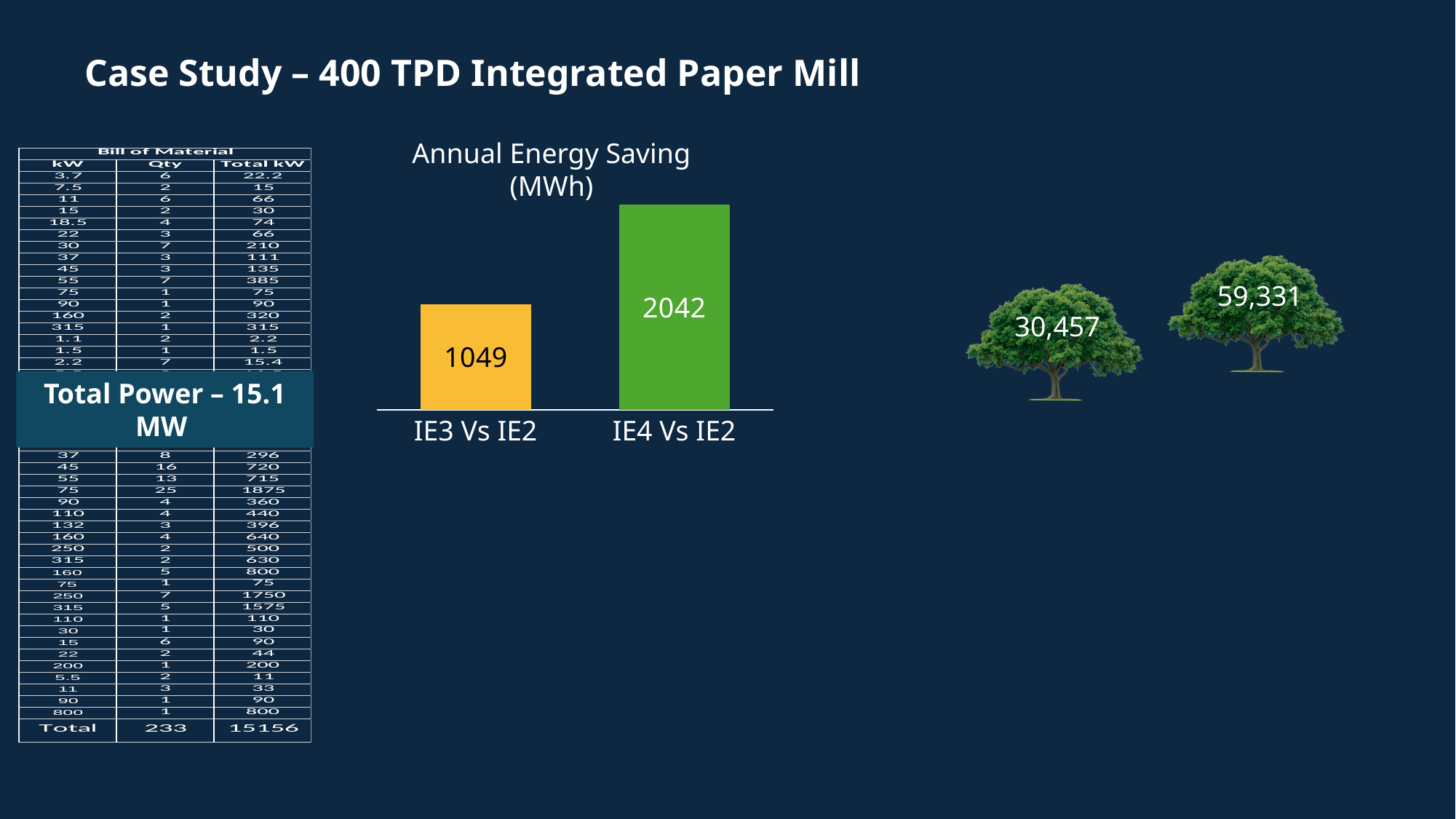
What is the difference between the IE4 Vs IE2 and IE3 Vs IE2 values in the Annual Energy Saving (MWh) chart? 993 Which category has the highest value in the Annual Energy Saving (MWh) chart? IE4 Vs IE2 What is the annual energy saving value for IE3 Vs IE2 in the Annual Energy Saving (MWh) chart? 1049 What is the title of the chart on the slide? Annual Energy Saving (MWh) In the Annual Energy Saving (MWh) chart, which is larger: IE3 Vs IE2 or IE4 Vs IE2? IE4 Vs IE2 What colour is the IE4 Vs IE2 bar in the Annual Energy Saving (MWh) chart? green How many categories are shown in the Annual Energy Saving (MWh) chart? 2 Which category has the lowest value in the Annual Energy Saving (MWh) chart? IE3 Vs IE2 What is the annual energy saving value for IE4 Vs IE2 in the Annual Energy Saving (MWh) chart? 2042 What kind of chart is the Annual Energy Saving (MWh) chart? bar chart Do the values rise or fall from IE3 Vs IE2 to IE4 Vs IE2 in the Annual Energy Saving (MWh) chart? rise